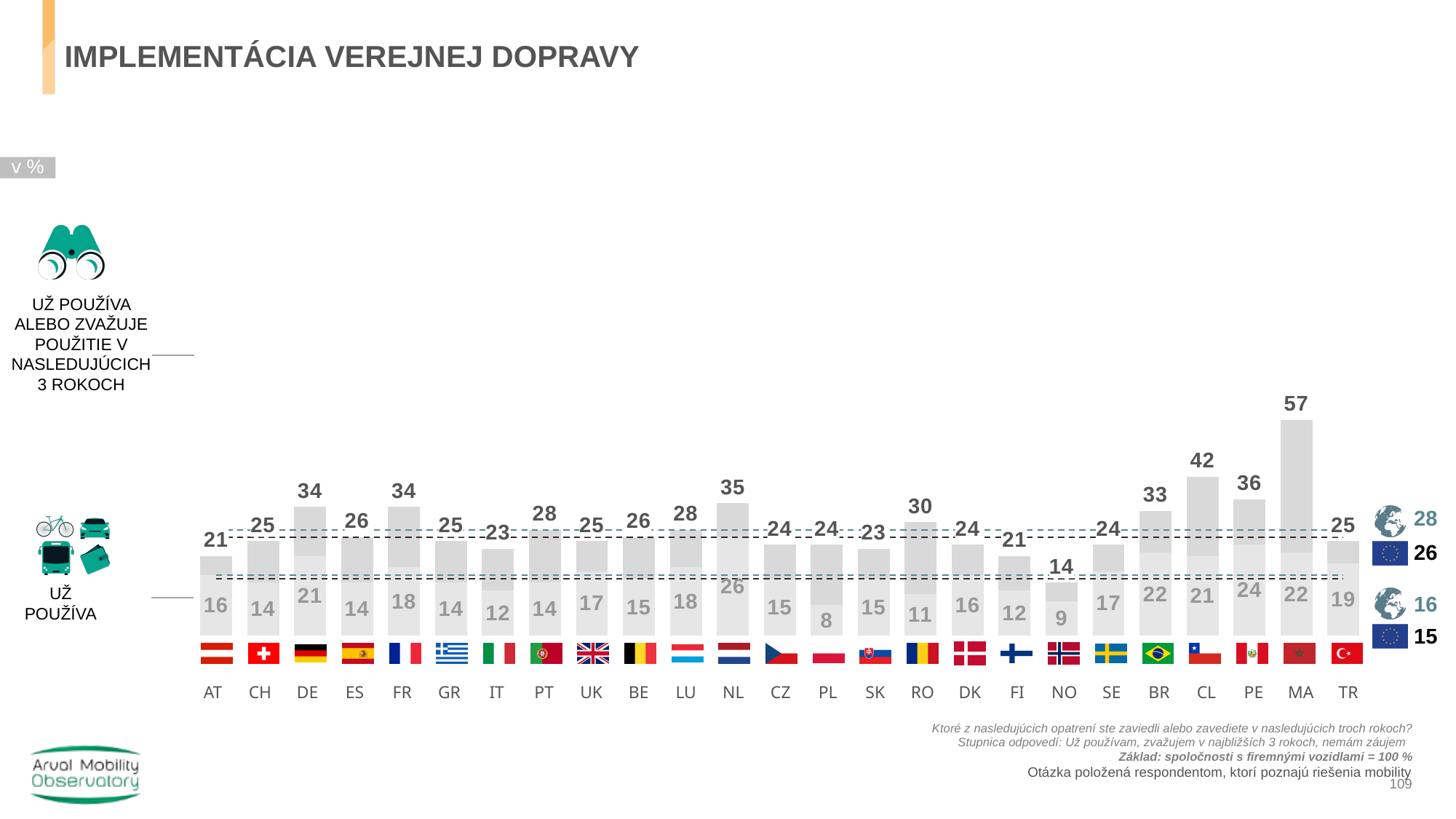
Which country has the highest value for 'Už používa alebo zvažuje použitie v nasledujúcich 3 rokoch'? MA How many countries are shown on the x axis? 25 What is the 'Už používa' value for NL? 26 What is the global average value shown for 'Už používa' on the right side of the chart? 16 What is the difference between the 'Už používa' values for NL and AT? 10 What is the 'Už používa' value for PL? 8 Which country has the lowest value for 'Už používa alebo zvažuje použitie v nasledujúcich 3 rokoch'? NO What is the difference between the 'Už používa alebo zvažuje' values for MA and CL? 15 Which has a higher 'Už používa alebo zvažuje' value, DE or RO? DE Which country has the lowest 'Už používa' value? PL What kind of chart is shown on the slide? Bar chart What is the value for MA for 'Už používa alebo zvažuje použitie v nasledujúcich 3 rokoch'? 57